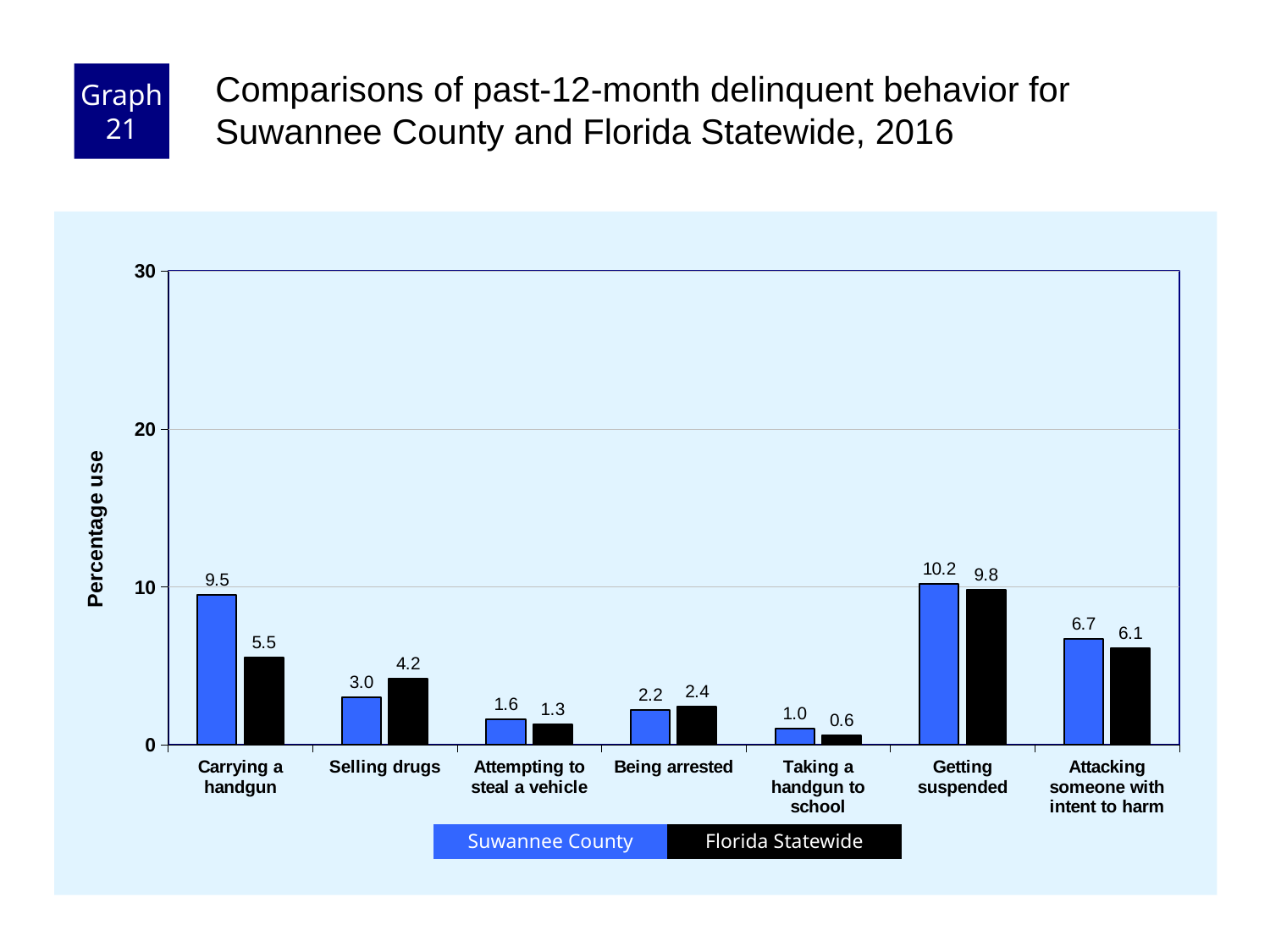
What kind of chart is shown on the slide? Bar chart Is the Suwannee County value for Getting suspended greater or less than 10? greater How many categories are shown on the x axis? 7 What is the Suwannee County value for Taking a handgun to school? 1.0 Which category has the highest Suwannee County value? Getting suspended What is the label of the y axis? Percentage use How many series does the legend list? 2 Which is larger for Being arrested: Suwannee County or Florida Statewide? Florida Statewide Which category has the lowest Florida Statewide value? Taking a handgun to school What is the Suwannee County value for Carrying a handgun? 9.5 What is the difference between the Suwannee County and Florida Statewide values for Carrying a handgun? 4.0 What is the Florida Statewide value for Selling drugs? 4.2